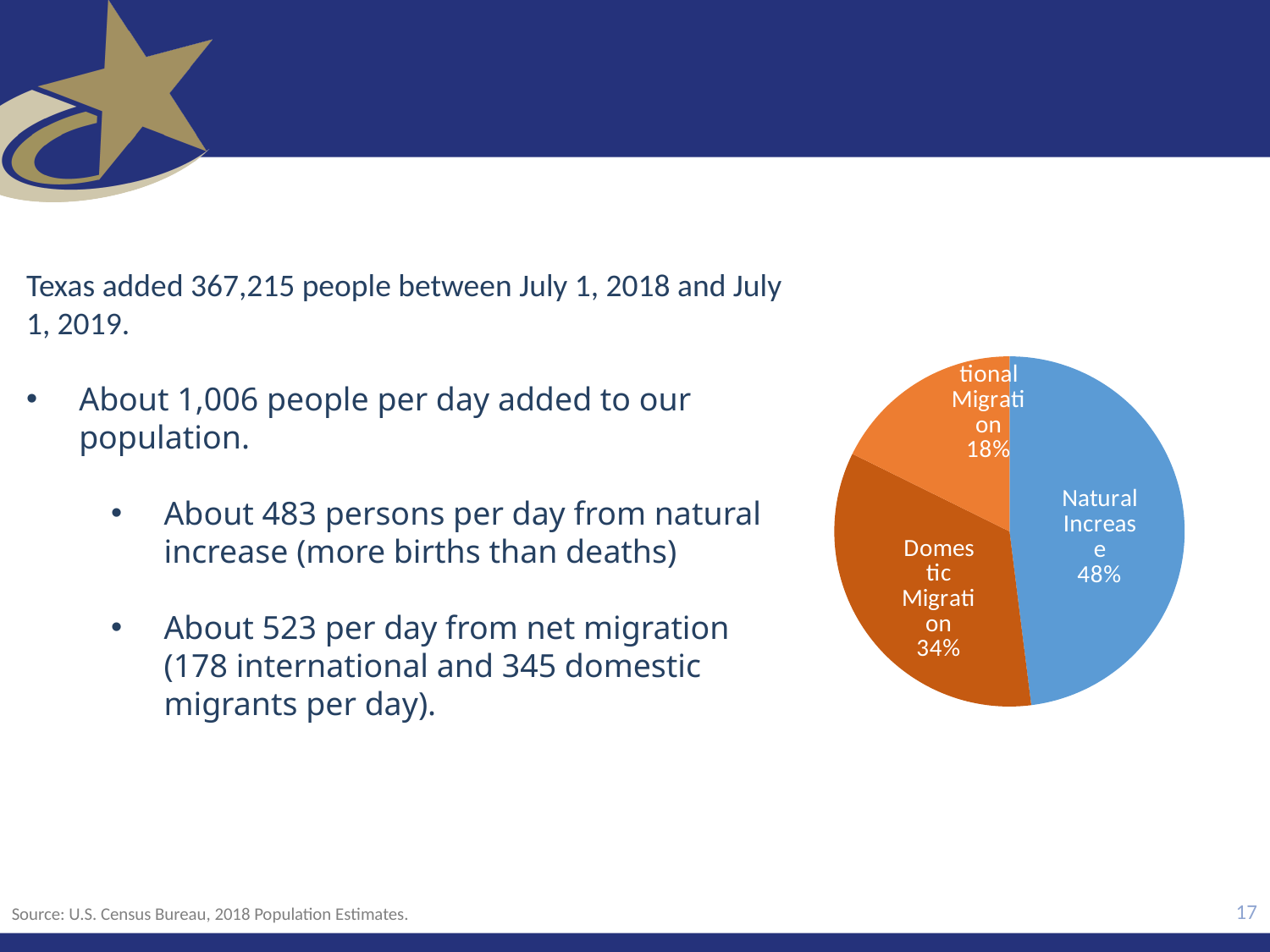
What share of the pie does Domestic Migration account for? 34% What share of the pie does International Migration account for? 18% How many slices does the pie chart have? 3 How many percentage points larger is the Natural Increase slice than the Domestic Migration slice? 14 percentage points How many percentage points larger is the Domestic Migration slice than the International Migration slice? 16 percentage points What is the combined share of the Domestic Migration and International Migration slices? 52% What kind of chart is shown on the slide? pie chart Which is larger, the Domestic Migration slice or the International Migration slice? Domestic Migration Which slice of the pie is the smallest? International Migration Which slice of the pie is the largest? Natural Increase What share of the pie does Natural Increase account for? 48% What colour is the Natural Increase slice? blue